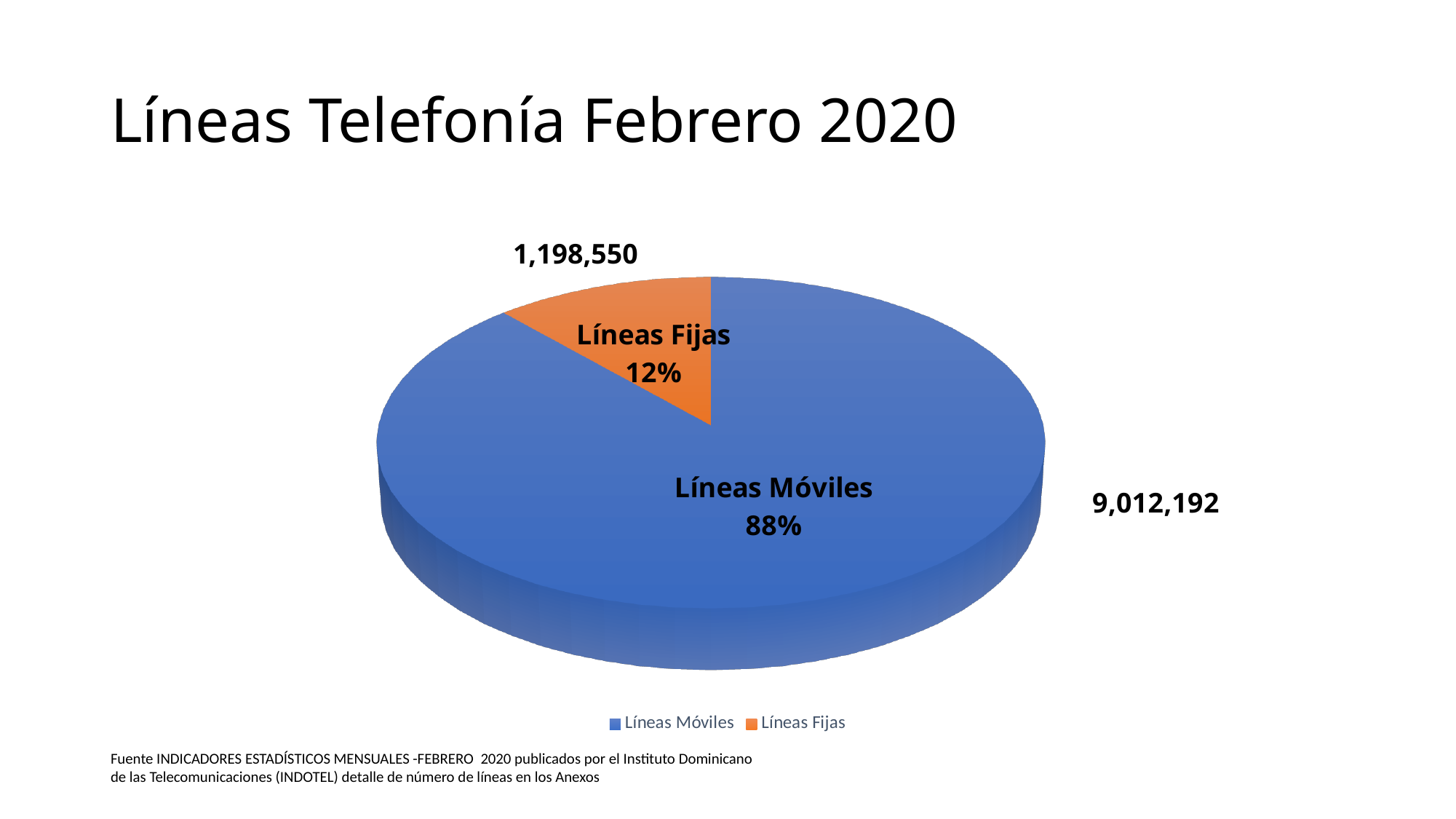
How many entries does the legend list? 2 Which category has the smallest slice? Líneas Fijas What colour is the Líneas Fijas slice? orange Which category has the largest slice? Líneas Móviles What is the difference between the values for Líneas Móviles and Líneas Fijas? 7,813,642 What is the value for Líneas Móviles? 9,012,192 Which is larger, Líneas Fijas or Líneas Móviles? Líneas Móviles How many slices does the pie chart have? 2 What share of the pie does Líneas Móviles represent? 88% What share of the pie does Líneas Fijas represent? 12% What is the value for Líneas Fijas? 1,198,550 What kind of chart is shown on the slide? pie chart